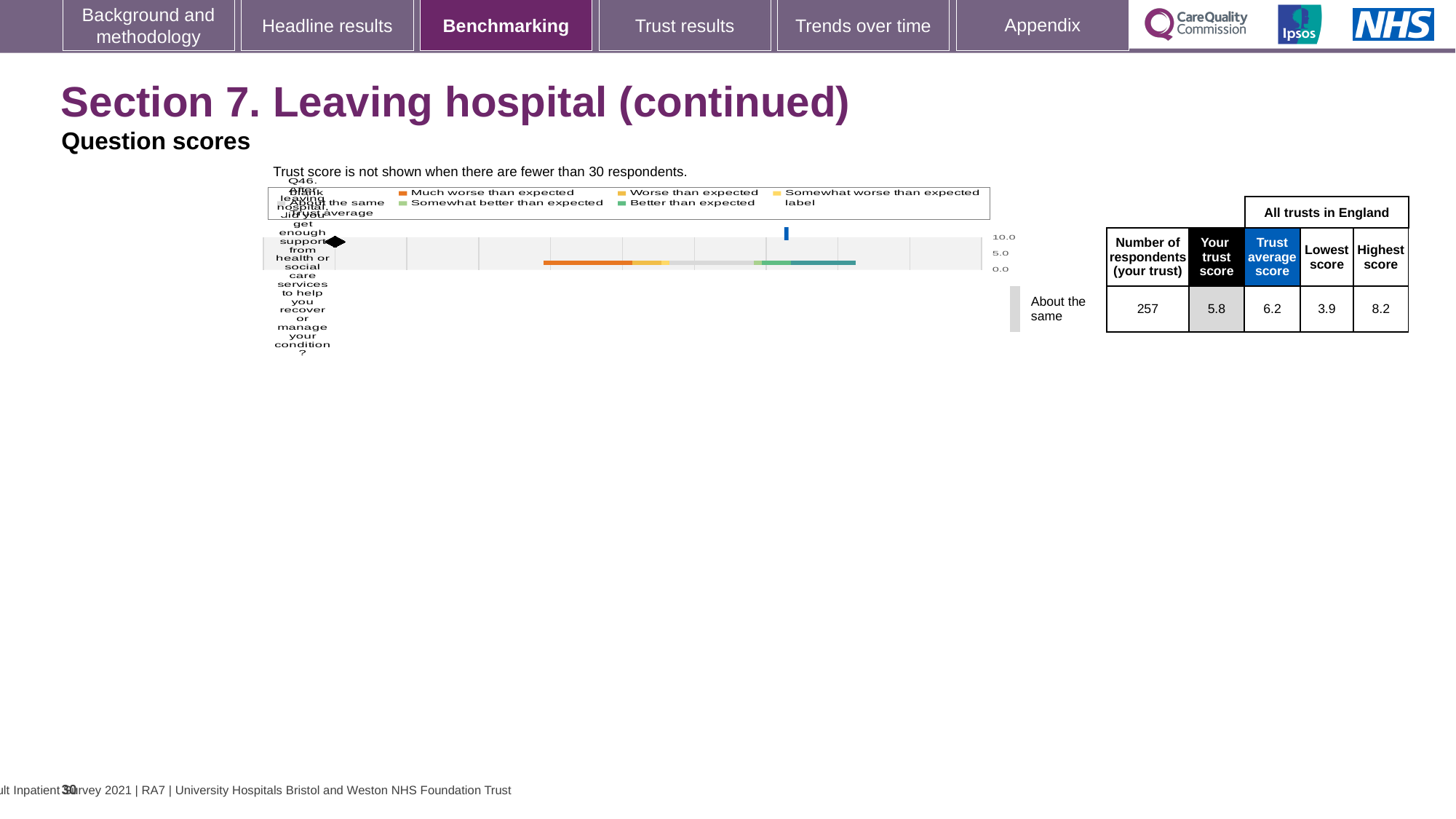
What is your trust score shown in the table next to the chart? 5.8 What is the difference between the trust average score and your trust score? 0.4 What is the lowest score among all trusts in England shown in the table? 3.9 What benchmark category is your trust's result labelled as next to the chart? About the same What is the highest score among all trusts in England shown in the table? 8.2 What kind of chart is shown on the slide? bar chart Which is larger, your trust score or the trust average score? Trust average score What is the highest value shown on the chart's axis? 10.0 What is the number of respondents for your trust shown in the table next to the chart? 257 What is the difference between the highest score and the lowest score among all trusts in England? 4.3 What is the trust average score for all trusts in England shown in the table? 6.2